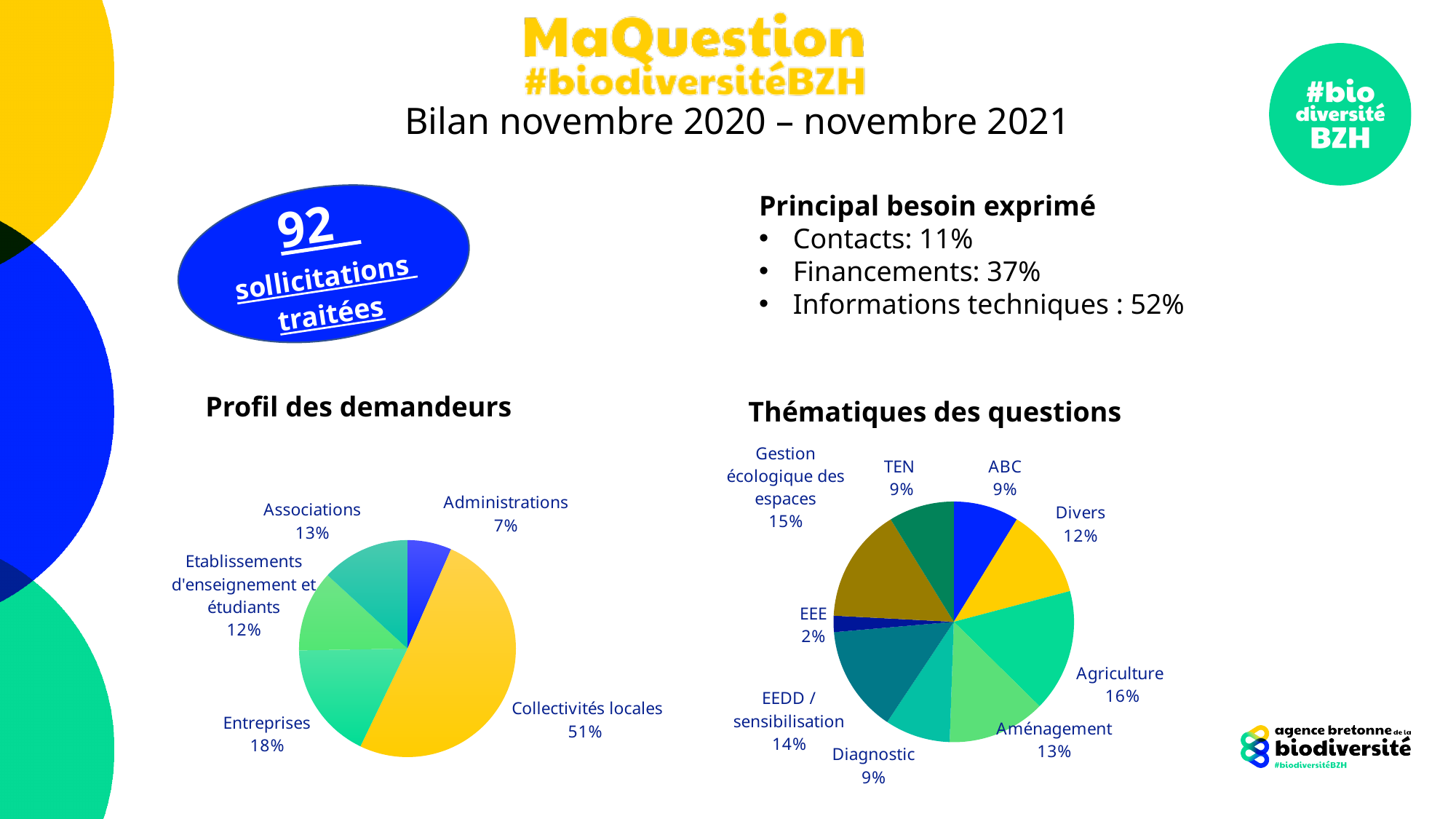
In the 'Profil des demandeurs' chart, which category has the smallest share? Administrations What kind of chart is 'Thématiques des questions'? Pie chart In the 'Profil des demandeurs' chart, what is the value for Entreprises? 18% In the 'Thématiques des questions' chart, what is the difference between EEDD / sensibilisation and Divers? 2% In the 'Thématiques des questions' chart, which category has the largest share? Agriculture In the 'Thématiques des questions' chart, what is the value for Agriculture? 16% In the 'Profil des demandeurs' chart, how many categories are shown? 5 In the 'Thématiques des questions' chart, which is larger: Gestion écologique des espaces or Aménagement? Gestion écologique des espaces In the 'Profil des demandeurs' chart, what is the difference between Associations and Administrations? 6% In the 'Thématiques des questions' chart, how many categories are shown? 9 In the 'Thématiques des questions' chart, which category has the smallest share? EEE In the 'Profil des demandeurs' chart, what share do Collectivités locales represent? 51%